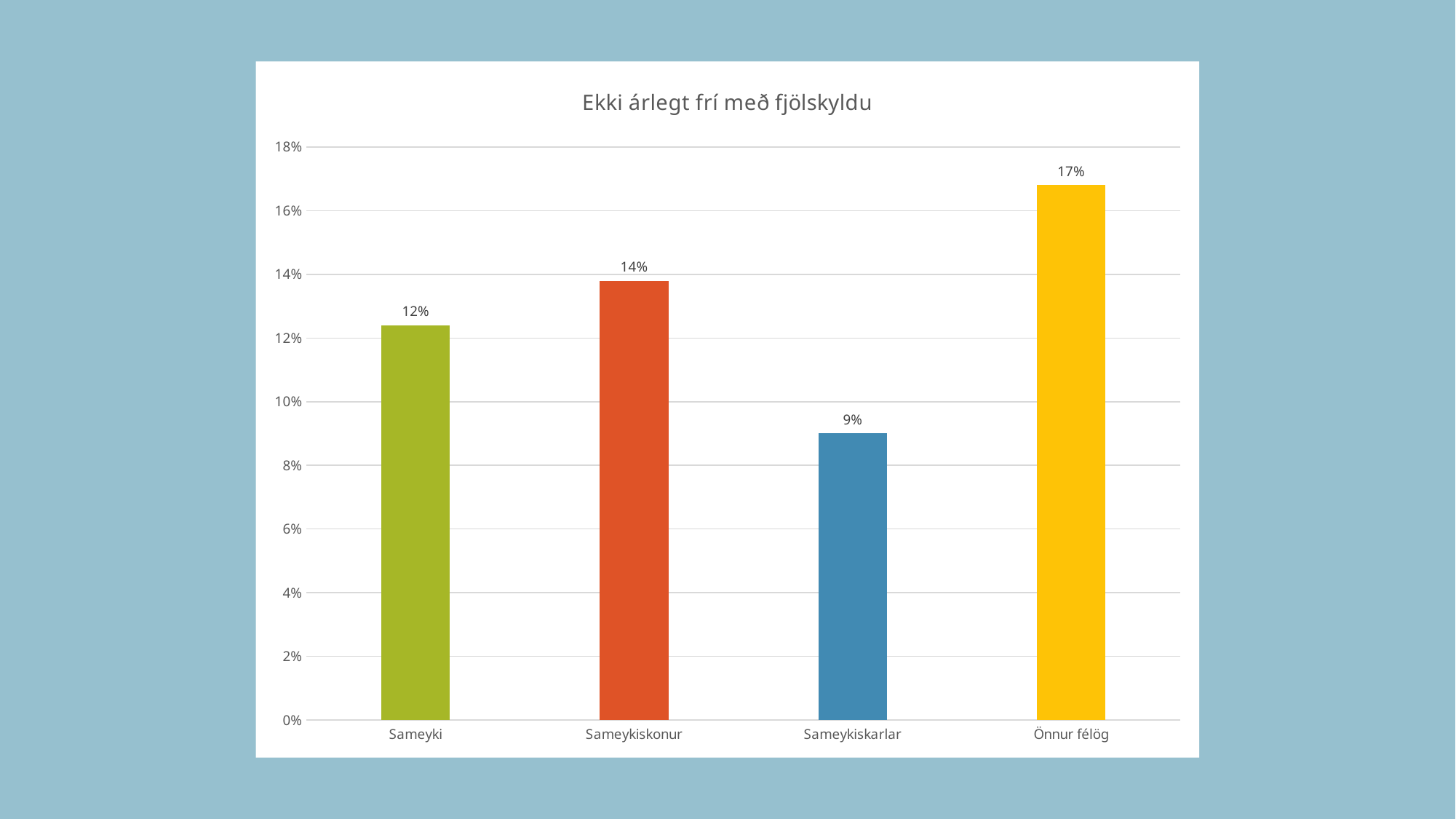
What is the value for Önnur félög? 17% Which category has the highest value? Önnur félög Which category has the lowest value? Sameykiskarlar Which is larger, the value for Sameykiskonur or the value for Sameyki? Sameykiskonur What is the difference between the values for Önnur félög and Sameykiskarlar? 8% What is the value for Sameykiskarlar? 9% What kind of chart is shown on the slide? bar chart What is the title of the chart? Ekki árlegt frí með fjölskyldu What is the value for Sameyki? 12% How many categories are shown on the x axis? 4 Is the value for Sameykiskarlar greater or less than 10%? less What is the value for Sameykiskonur? 14%